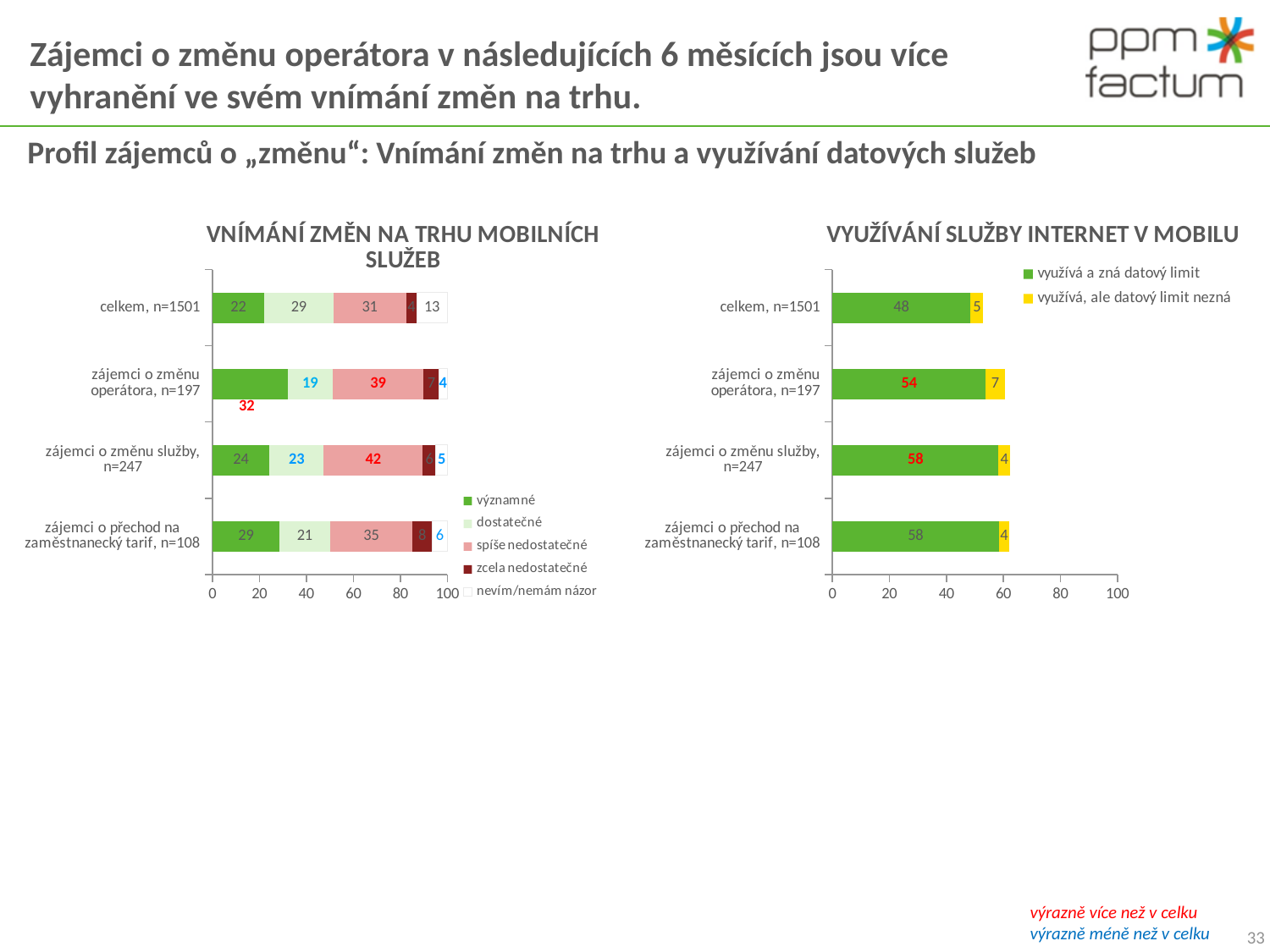
What kind of chart is "VYUŽÍVÁNÍ SLUŽBY INTERNET V MOBILU"? stacked bar chart In the chart "VNÍMÁNÍ ZMĚN NA TRHU MOBILNÍCH SLUŽEB", which category has the lowest value for "nevím/nemám názor"? zájemci o změnu operátora, n=197 In the chart "VYUŽÍVÁNÍ SLUŽBY INTERNET V MOBILU", what is the total of the stacked bar for "zájemci o změnu operátora, n=197"? 61 In the chart "VYUŽÍVÁNÍ SLUŽBY INTERNET V MOBILU", what is the value of "využívá a zná datový limit" for "zájemci o změnu operátora, n=197"? 54 In the chart "VNÍMÁNÍ ZMĚN NA TRHU MOBILNÍCH SLUŽEB", what is the difference between the "spíše nedostatečné" values for "zájemci o změnu služby, n=247" and "celkem, n=1501"? 11 In the chart "VYUŽÍVÁNÍ SLUŽBY INTERNET V MOBILU", is the "využívá a zná datový limit" value larger for "celkem, n=1501" or for "zájemci o změnu služby, n=247"? zájemci o změnu služby, n=247 In the chart "VNÍMÁNÍ ZMĚN NA TRHU MOBILNÍCH SLUŽEB", what is the value of "nevím/nemám názor" for "celkem, n=1501"? 13 In the chart "VYUŽÍVÁNÍ SLUŽBY INTERNET V MOBILU", which category has the lowest value for "využívá a zná datový limit"? celkem, n=1501 In the chart "VNÍMÁNÍ ZMĚN NA TRHU MOBILNÍCH SLUŽEB", what is the value of "spíše nedostatečné" for "zájemci o změnu služby, n=247"? 42 In the chart "VNÍMÁNÍ ZMĚN NA TRHU MOBILNÍCH SLUŽEB", which category has the highest value for "významné"? zájemci o změnu operátora, n=197 How many series does the legend of the chart "VNÍMÁNÍ ZMĚN NA TRHU MOBILNÍCH SLUŽEB" list? 5 In the chart "VYUŽÍVÁNÍ SLUŽBY INTERNET V MOBILU", which category has the highest value for "využívá, ale datový limit nezná"? zájemci o změnu operátora, n=197